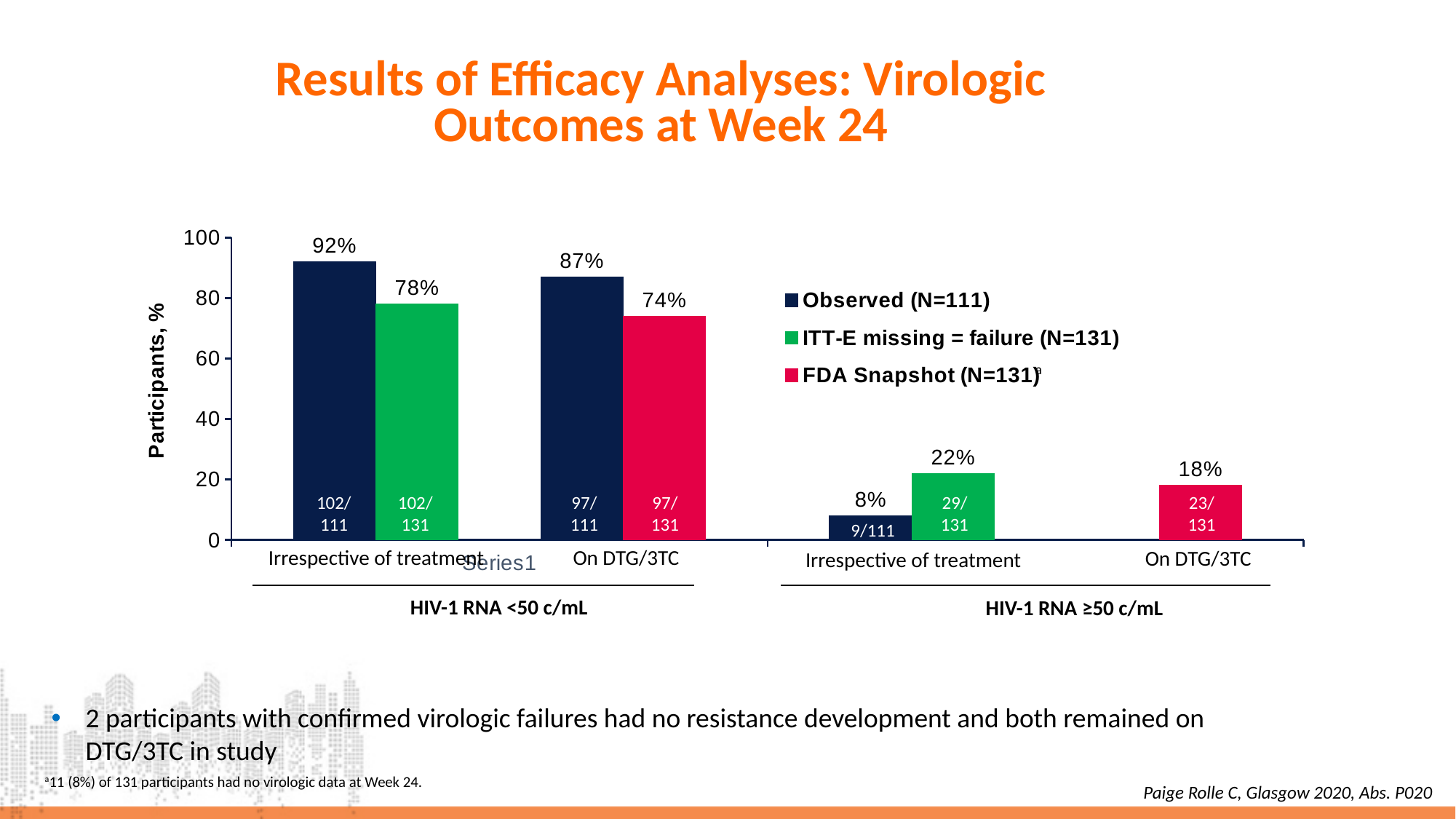
Which bar has the lowest value on the chart? Observed, Irrespective of treatment (HIV-1 RNA ≥50 c/mL) How many series does the legend list? 3 What is the FDA Snapshot value for 'On DTG/3TC' in the HIV-1 RNA <50 c/mL group? 74% In the HIV-1 RNA ≥50 c/mL group, which is larger: the ITT-E missing = failure value for 'Irrespective of treatment' or the FDA Snapshot value for 'On DTG/3TC'? ITT-E missing = failure, Irrespective of treatment What is the label of the y axis? Participants, % What is the Observed value for 'Irrespective of treatment' in the HIV-1 RNA <50 c/mL group? 92% What is the ITT-E missing = failure value for 'Irrespective of treatment' in the HIV-1 RNA <50 c/mL group? 78% What kind of chart is shown on the slide? Bar chart Which bar has the highest value on the chart? Observed, Irrespective of treatment (HIV-1 RNA <50 c/mL) What is the difference between the Observed value (92%) and the ITT-E missing = failure value (78%) for 'Irrespective of treatment' in the HIV-1 RNA <50 c/mL group? 14 percentage points What fraction is printed inside the Observed bar for 'On DTG/3TC' in the HIV-1 RNA <50 c/mL group? 97/111 What is the ITT-E missing = failure value for 'Irrespective of treatment' in the HIV-1 RNA ≥50 c/mL group? 22%